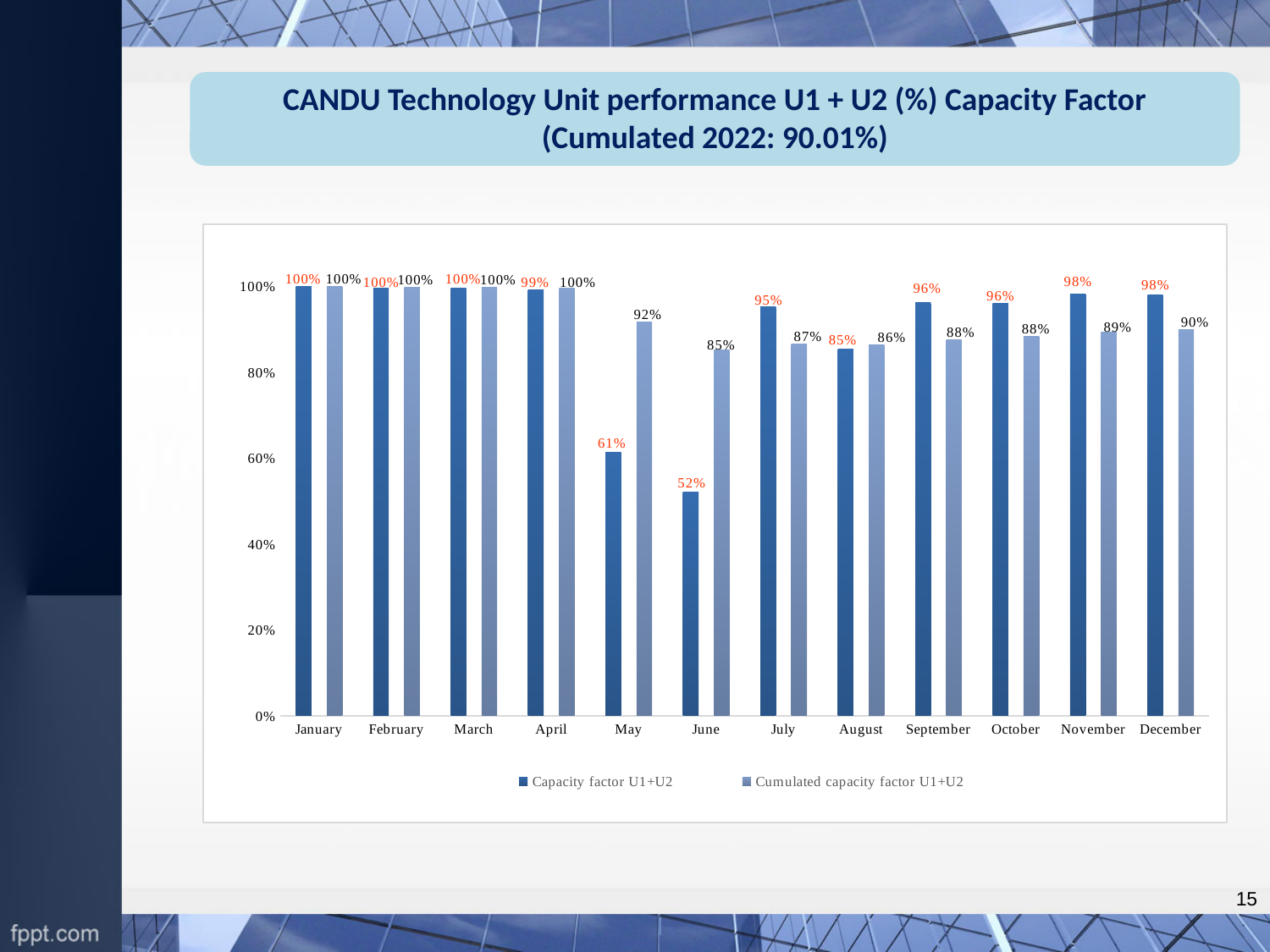
How many months are shown on the x axis? 12 What kind of chart is shown on the slide? Bar chart What is the difference between the Capacity factor U1+U2 and the Cumulated capacity factor U1+U2 in May? 31% Which month has the lowest Capacity factor U1+U2? June Does the Cumulated capacity factor U1+U2 rise or fall from June to December? Rise What is the Cumulated capacity factor U1+U2 value for December? 90% What is the Capacity factor U1+U2 value for May? 61% What is the Capacity factor U1+U2 value for June? 52% What cumulated 2022 capacity factor is stated in the slide title? 90.01% Which is larger in July: the Capacity factor U1+U2 or the Cumulated capacity factor U1+U2? Capacity factor U1+U2 Which month has the lowest Cumulated capacity factor U1+U2? June How many series does the legend list? 2